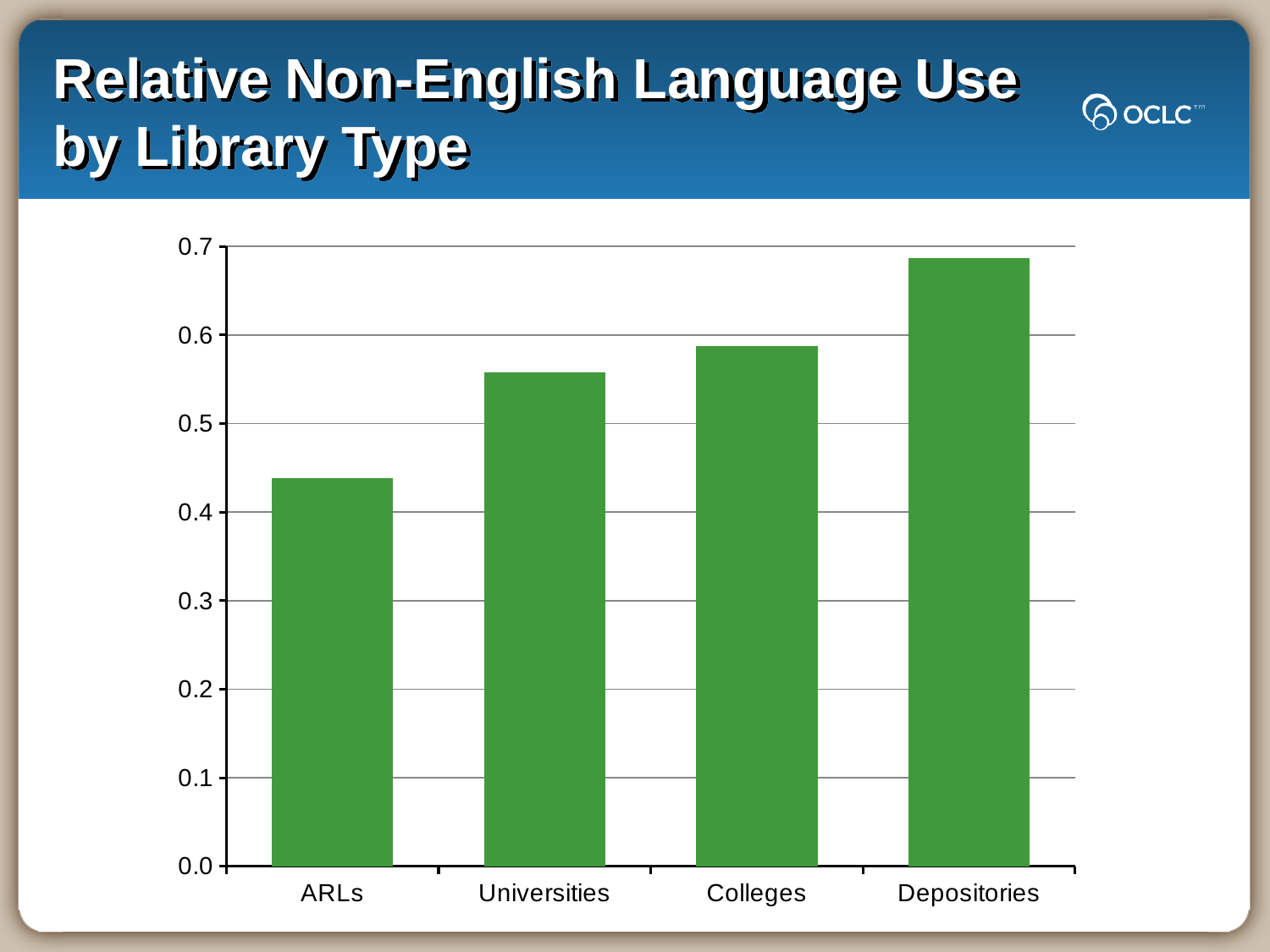
Is the value for Universities greater or less than 0.5? greater Which library type has the lowest relative non-English language use? ARLs Is the value for Colleges greater or less than 0.5? greater Is the value for ARLs greater or less than 0.5? less Do the values rise or fall moving from ARLs to Depositories along the x axis? rise How many library types are shown on the x axis of the chart? 4 Which is larger, the value for ARLs or the value for Universities? Universities Which library type has the highest relative non-English language use? Depositories What is the title of the slide containing the chart? Relative Non-English Language Use by Library Type What kind of chart is shown on the slide? bar chart